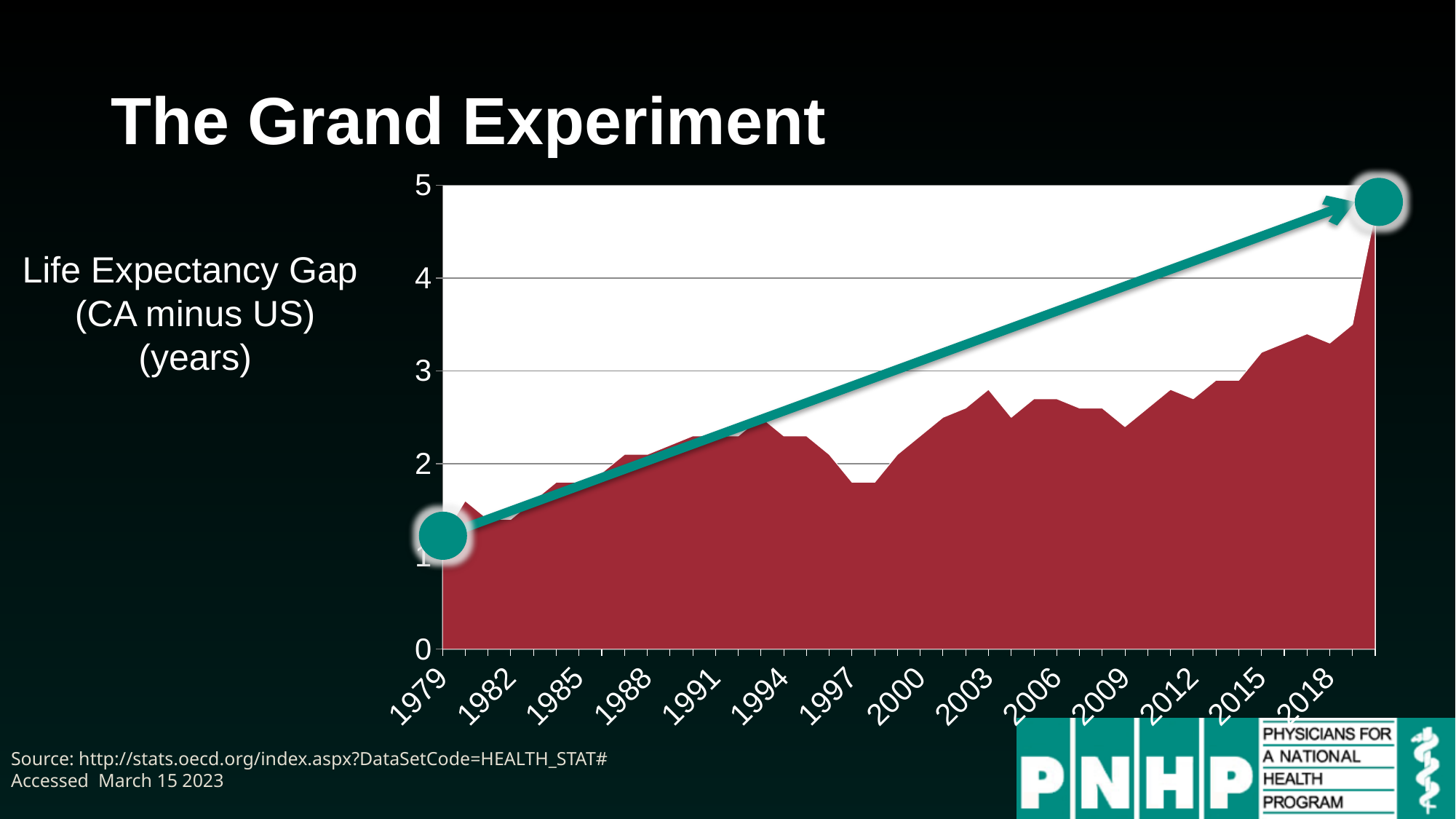
Is the value for 1994 greater or less than 3? less Is the value for 2012 greater or less than 3? less Is the value for 2018 greater or less than 3? greater Which has the larger value, 2003 or 1997? 2003 What kind of chart is shown on the slide? Area chart Which labelled year has the lowest value on the chart? 1979 Which has the larger value, 1985 or 2015? 2015 What quantity does the chart plot, according to the label to its left? Life Expectancy Gap (CA minus US) (years) How many year labels are shown on the x axis? 14 Does the life expectancy gap generally rise or fall from 1979 to the end of the series? Rise